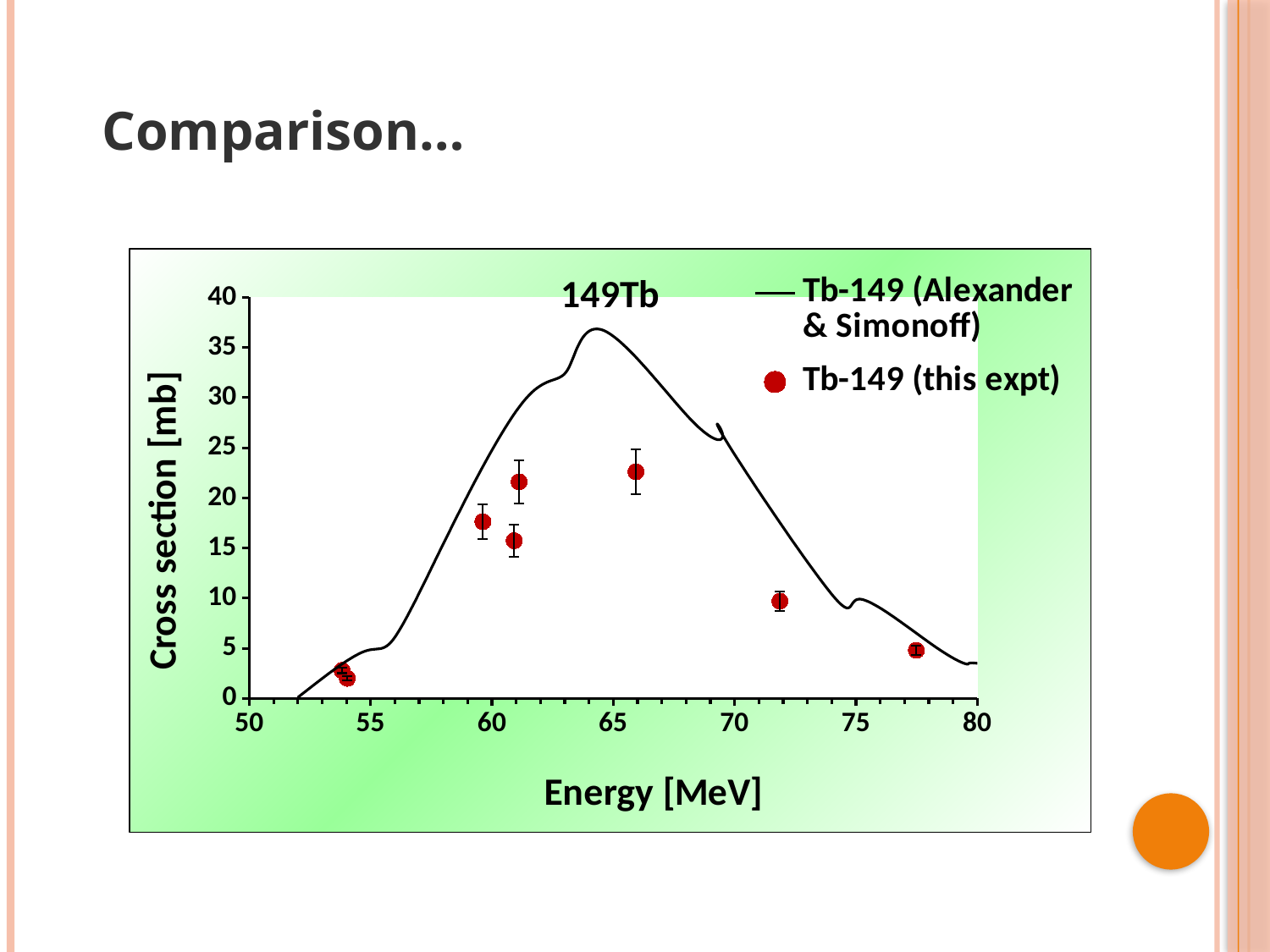
What is the label of the x axis? Energy [MeV] Is the peak value of the Tb-149 (Alexander & Simonoff) curve greater or less than 35? greater Are the lowest Tb-149 (this expt) points at the low-energy end or the high-energy end of the x axis? low-energy end What is the title shown on the chart? 149Tb At about 66 MeV, which is higher: the Tb-149 (Alexander & Simonoff) curve or the Tb-149 (this expt) point? Tb-149 (Alexander & Simonoff) curve What kind of chart is this? Line chart with scatter data points Does the Tb-149 (Alexander & Simonoff) curve rise or fall between 65 MeV and 80 MeV? fall Is the Tb-149 (this expt) value at about 77.5 MeV greater or less than 10? less How many series does the legend list? 2 Is the Tb-149 (Alexander & Simonoff) curve value at 80 MeV greater or less than 5? less